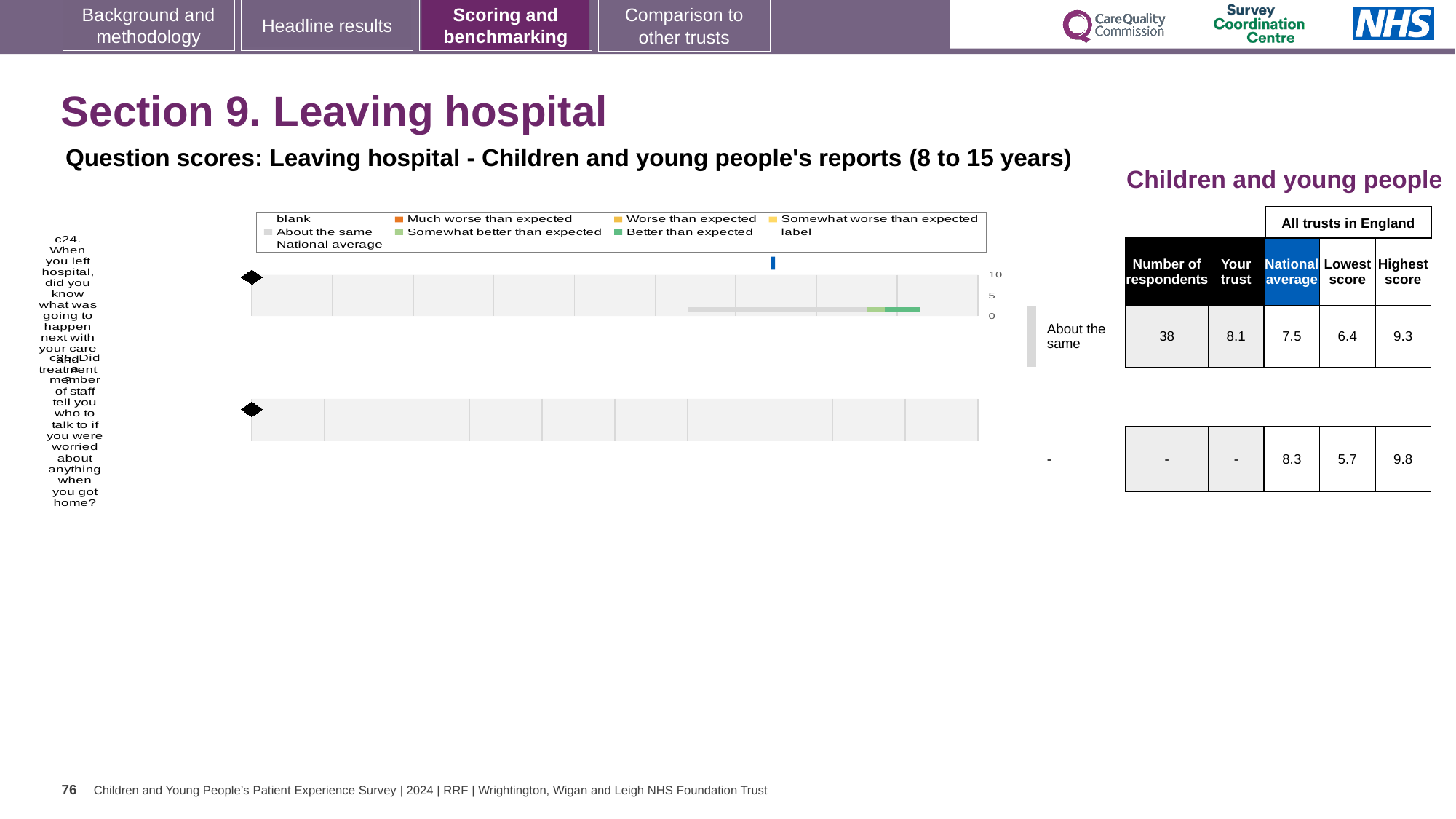
How many questions (categories) are plotted in the chart? 2 What is the number of respondents for question c24? 38 What is the 'Your trust' score for question c24 (When you left hospital, did you know what was going to happen next with your care and treatment)? 8.1 What is the lowest score among all trusts in England for question c25? 5.7 What kind of chart is used to show the question scores on this slide? bar chart Which is larger for question c24: the trust's score or the national average? Your trust What benchmarking category is shown for question c24? About the same How many entries does the chart legend list? 9 What is the national average score for question c24? 7.5 What is the difference between the trust's score and the national average for question c24? 0.6 What is the highest score among all trusts in England for question c24? 9.3 Which question has the higher national average, c24 or c25? c25